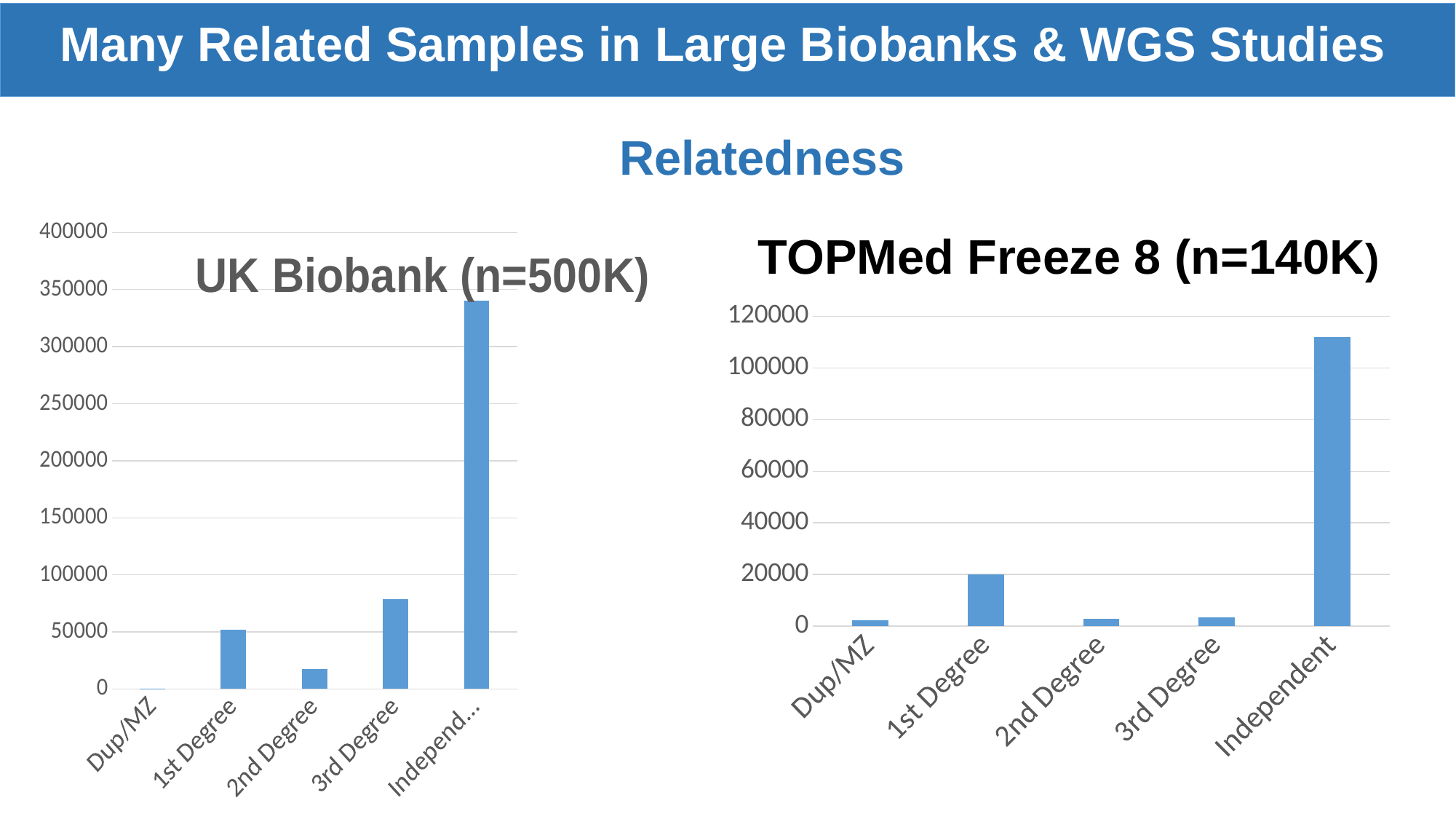
What kind of chart is the UK Biobank (n=500K) chart? bar chart In the TOPMed Freeze 8 (n=140K) chart, which category has the highest value? Independent In the UK Biobank (n=500K) chart, which category has the lowest value? Dup/MZ What is the highest value shown on the y axis of the TOPMed Freeze 8 (n=140K) chart? 120000 In the UK Biobank (n=500K) chart, is the value for 2nd Degree greater or less than 50000? less How many categories are shown on the x axis of the TOPMed Freeze 8 (n=140K) chart? 5 In the UK Biobank (n=500K) chart, which is larger, the value for 1st Degree or the value for 2nd Degree? 1st Degree In the TOPMed Freeze 8 (n=140K) chart, which is larger, the value for 1st Degree or the value for 2nd Degree? 1st Degree In the TOPMed Freeze 8 (n=140K) chart, is the value for 3rd Degree greater or less than 20000? less In the TOPMed Freeze 8 (n=140K) chart, is the value for Independent greater or less than 100000? greater